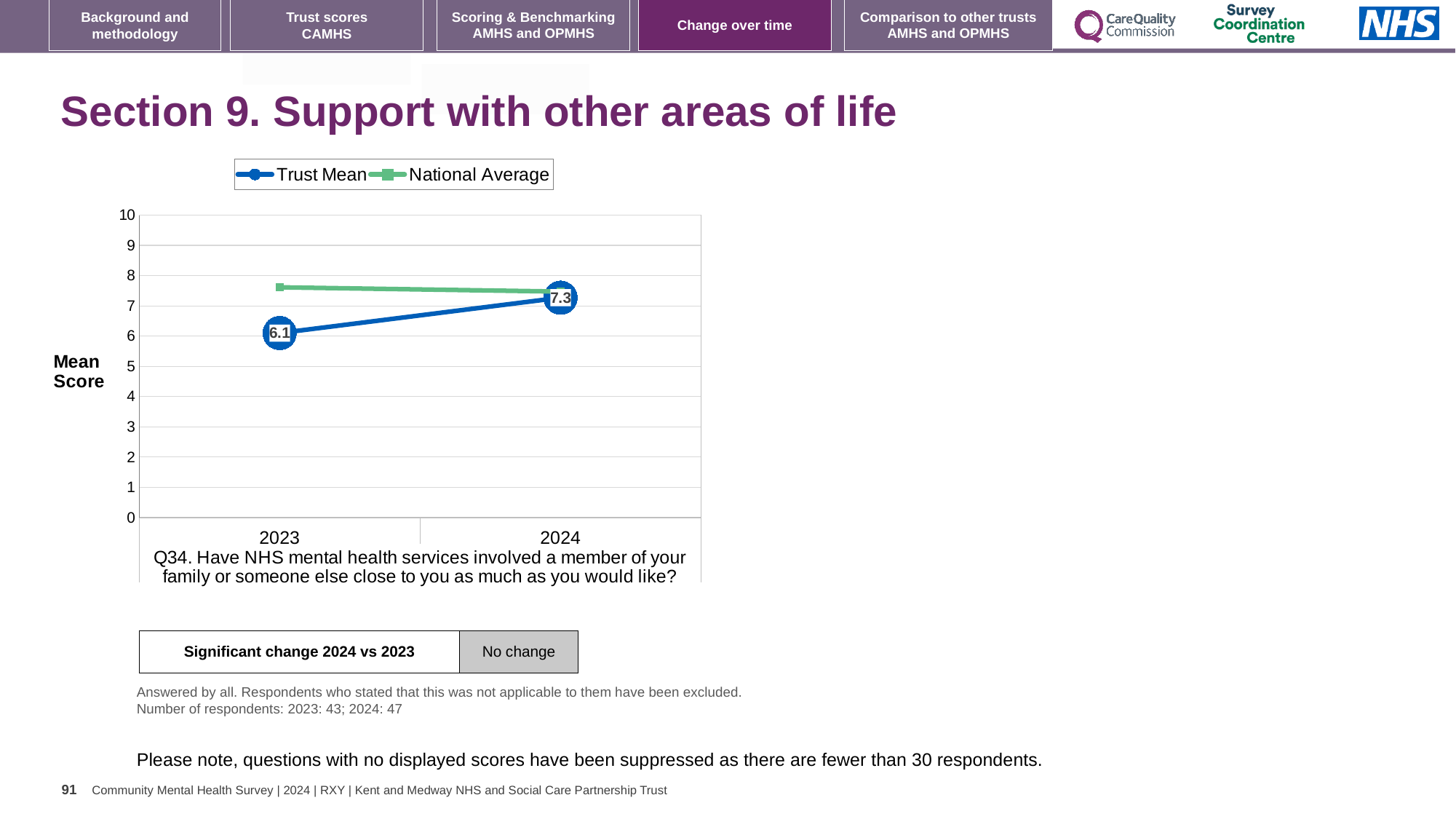
In which year is the Trust Mean score higher, 2023 or 2024? 2024 Is the National Average value for 2023 greater or less than 7? greater Is the National Average value for 2024 greater or less than 8? less By how much did the Trust Mean score change from 2023 to 2024? 1.2 How many years are plotted on the x axis? 2 In 2023, which is larger, the Trust Mean or the National Average? National Average How many series does the legend list? 2 What kind of chart is shown on the slide? Line chart What is the Trust Mean score for 2024? 7.3 In which year is the Trust Mean score lowest? 2023 What is the Trust Mean score for 2023? 6.1 Does the Trust Mean rise or fall from 2023 to 2024? Rise